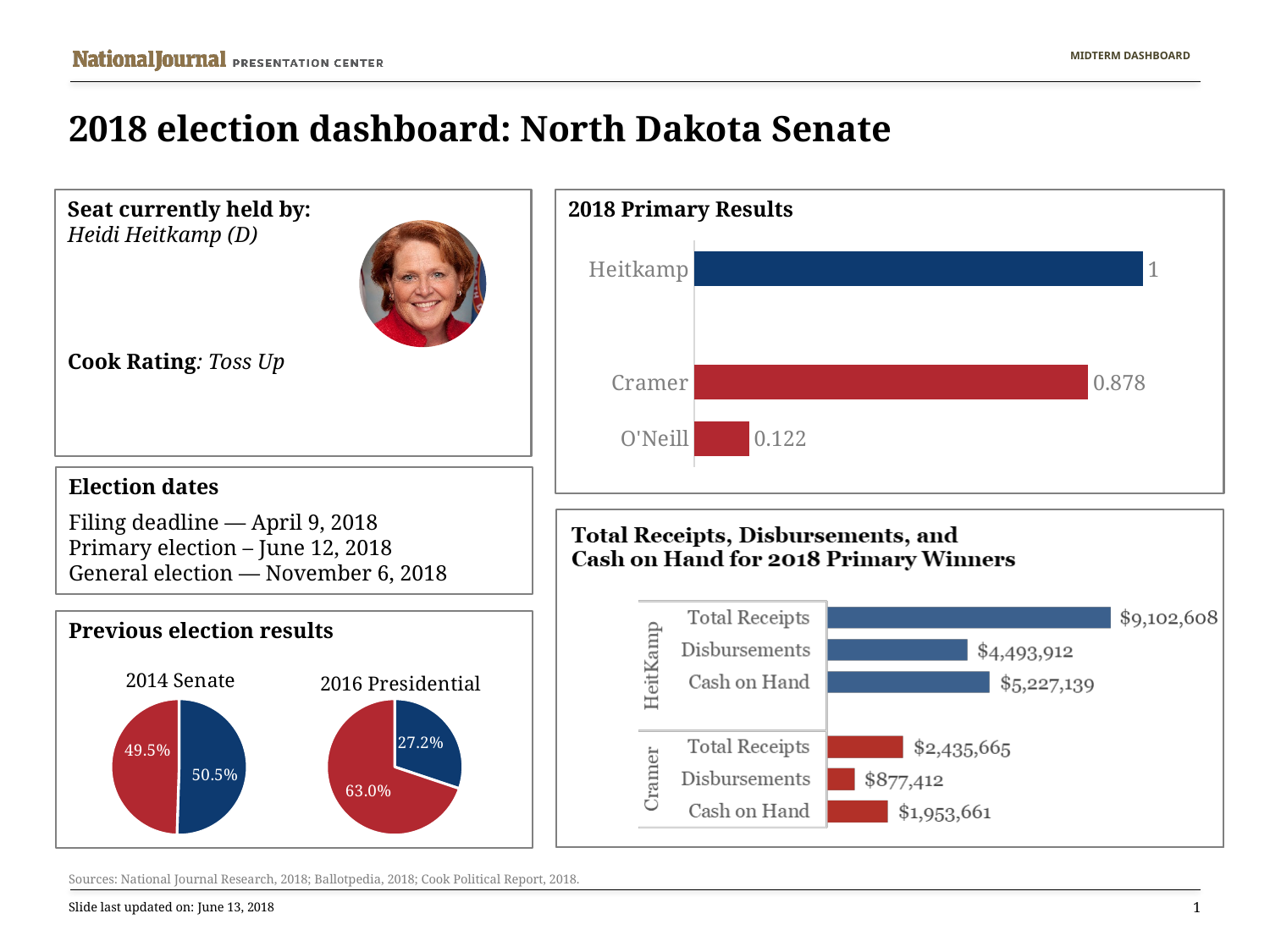
In the Total Receipts, Disbursements, and Cash on Hand chart, which is larger: Heitkamp's Disbursements or Heitkamp's Cash on Hand? Heitkamp's Cash on Hand In the 2018 Primary Results chart, which candidate has the lowest value? O'Neill In the Total Receipts, Disbursements, and Cash on Hand chart, what is the difference between Heitkamp's Total Receipts and Cramer's Total Receipts? $6,666,943 In the Total Receipts, Disbursements, and Cash on Hand chart, what is Cramer's Cash on Hand? $1,953,661 In the 2018 Primary Results chart, what value is shown for O'Neill? 0.122 What kind of chart is the 2018 Primary Results chart? Bar chart In the Total Receipts, Disbursements, and Cash on Hand chart, which bar has the smallest value? Cramer Disbursements In the 2018 Primary Results chart, how many candidates are shown? 3 In the Total Receipts, Disbursements, and Cash on Hand chart, what are Heitkamp's Total Receipts? $9,102,608 In the 2018 Primary Results chart, what value is shown for Cramer? 0.878 In the 2016 Presidential pie chart under Previous election results, what is the difference between the red slice and the blue slice? 35.8% In the 2014 Senate pie chart under Previous election results, what share does the blue slice show? 50.5%